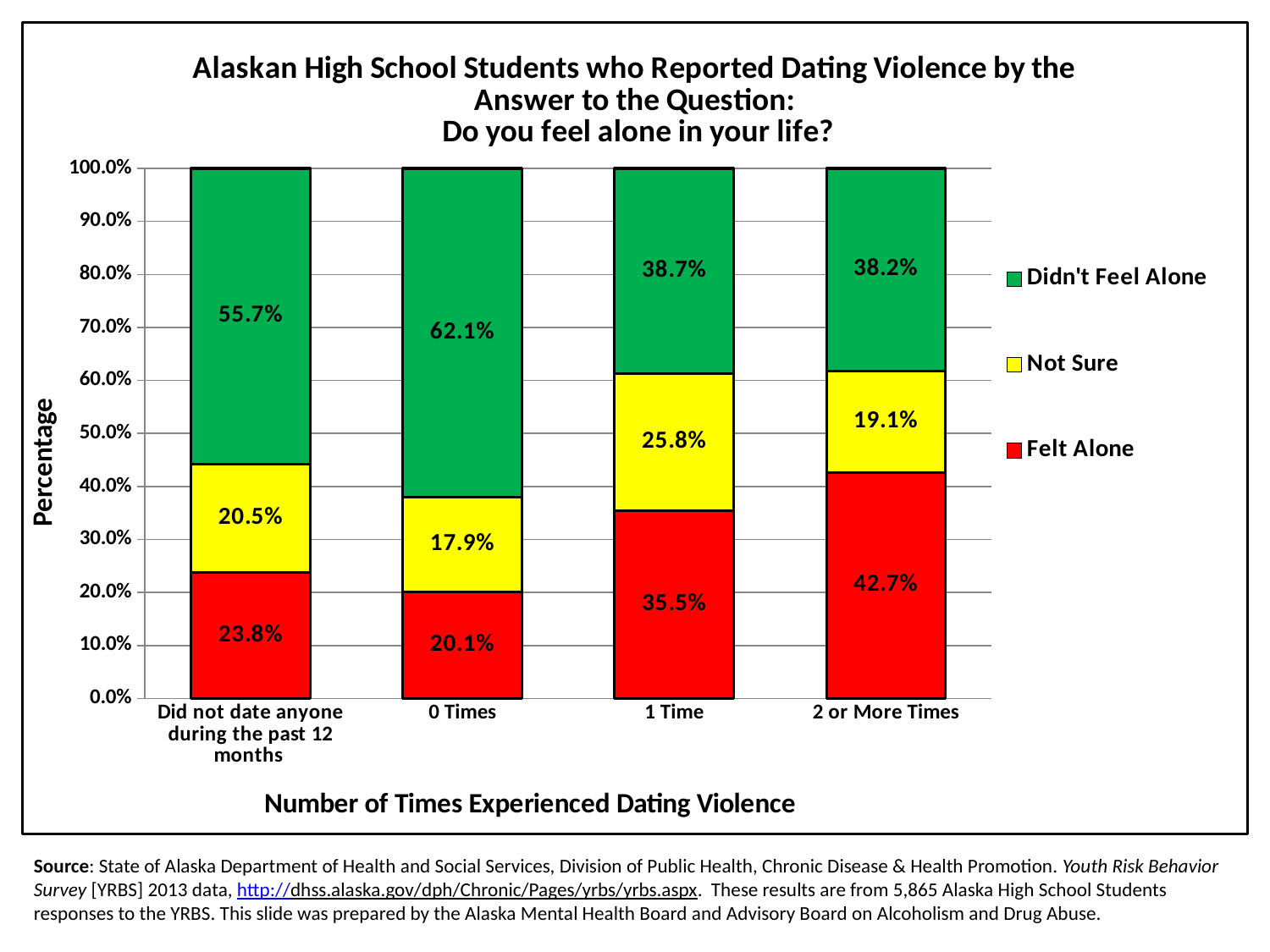
Which category has the lowest 'Not Sure' percentage? 0 Times How many series does the legend list? 3 What is the 'Felt Alone' value for students who did not date anyone during the past 12 months? 23.8% What kind of chart is shown on the slide? Stacked bar chart What is the difference between the 'Felt Alone' values for '2 or More Times' and '0 Times'? 22.6% How many categories are shown on the x axis? 4 What percentage of students with 0 times of dating violence didn't feel alone? 62.1% Which is larger: the 'Didn't Feel Alone' value for '1 Time' or for '2 or More Times'? 1 Time What colour represents the 'Felt Alone' series? Red What percentage of students who experienced dating violence 2 or more times reported feeling alone? 42.7% Which category has the highest 'Felt Alone' percentage? 2 or More Times What is the 'Not Sure' value for students who experienced dating violence 1 time? 25.8%